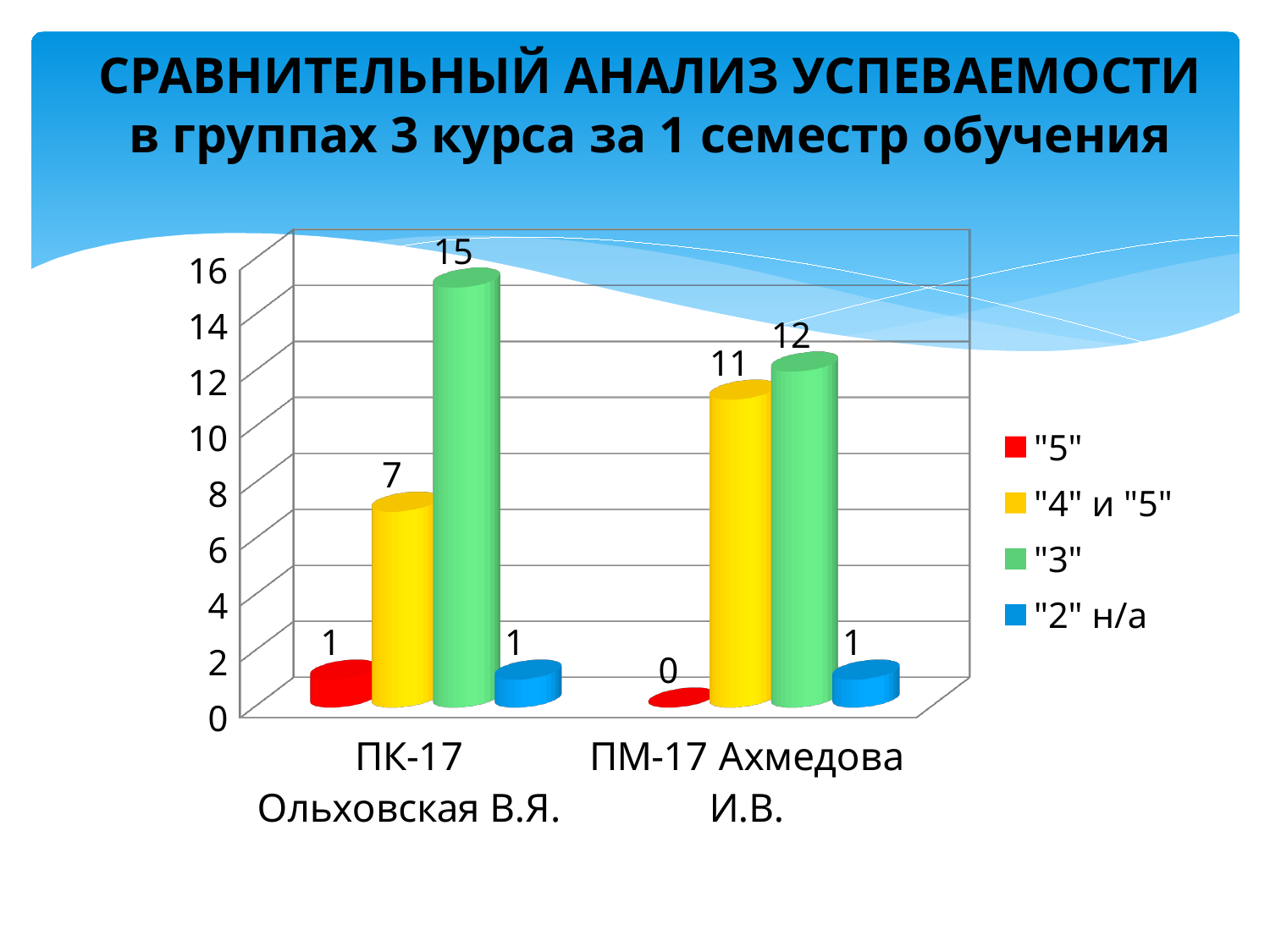
What kind of chart is shown on the slide? Bar chart How many groups (categories) are shown on the x axis? 2 Which series has the highest value in the ПК-17 Ольховская В.Я. group? "3" What is the value for "3" in the ПК-17 Ольховская В.Я. group? 15 What colour represents the "2" н/а series in the legend? Blue What is the value for "5" in the ПМ-17 Ахмедова И.В. group? 0 Which series has the lowest value in the ПМ-17 Ахмедова И.В. group? "5" What is the value for "4" и "5" in the ПМ-17 Ахмедова И.В. group? 11 What is the value for "2" н/а in the ПК-17 Ольховская В.Я. group? 1 What is the difference between the "3" values for ПК-17 Ольховская В.Я. and ПМ-17 Ахмедова И.В.? 3 How many series does the legend list? 4 Which group has the larger value for "4" и "5": ПК-17 Ольховская В.Я. or ПМ-17 Ахмедова И.В.? ПМ-17 Ахмедова И.В.